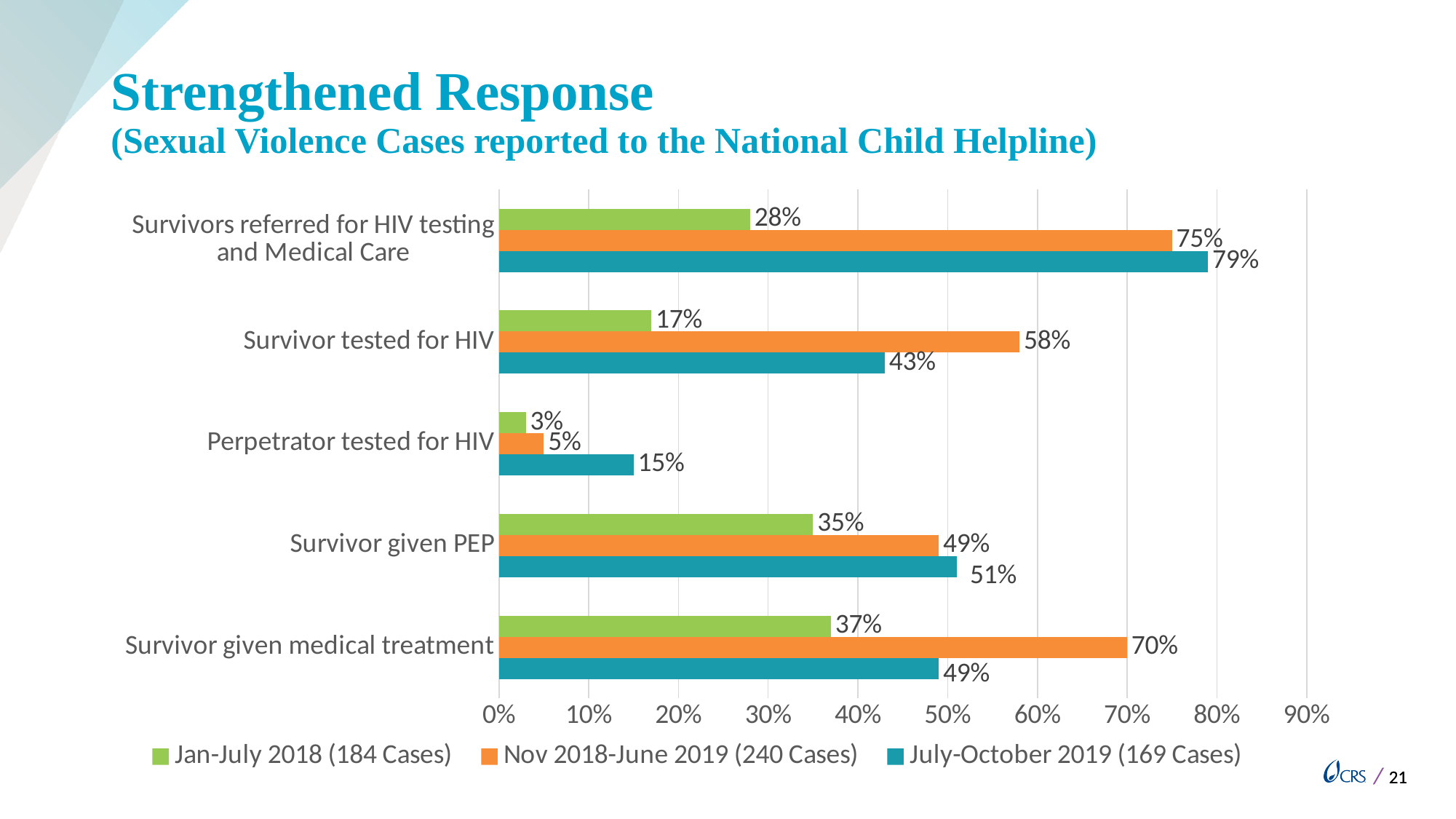
What is the value for Survivors referred for HIV testing and Medical Care in the July-October 2019 (169 Cases) series? 79% What is the value for Perpetrator tested for HIV in the Jan-July 2018 (184 Cases) series? 3% Which category has the lowest value in the July-October 2019 (169 Cases) series? Perpetrator tested for HIV Which colour represents the Nov 2018-June 2019 (240 Cases) series? Orange How many series does the legend list? 3 What is the difference between the Nov 2018-June 2019 and Jan-July 2018 values for Survivor tested for HIV? 41% What is the difference between the July-October 2019 and Jan-July 2018 values for Survivor given PEP? 16% For Survivor given medical treatment, which series has the larger value: Jan-July 2018 (184 Cases) or July-October 2019 (169 Cases)? July-October 2019 (169 Cases) What is the value for Survivor given medical treatment in the Nov 2018-June 2019 (240 Cases) series? 70% Which category has the highest value in the Nov 2018-June 2019 (240 Cases) series? Survivors referred for HIV testing and Medical Care What kind of chart is shown on the slide? Bar chart How many categories are shown on the chart? 5